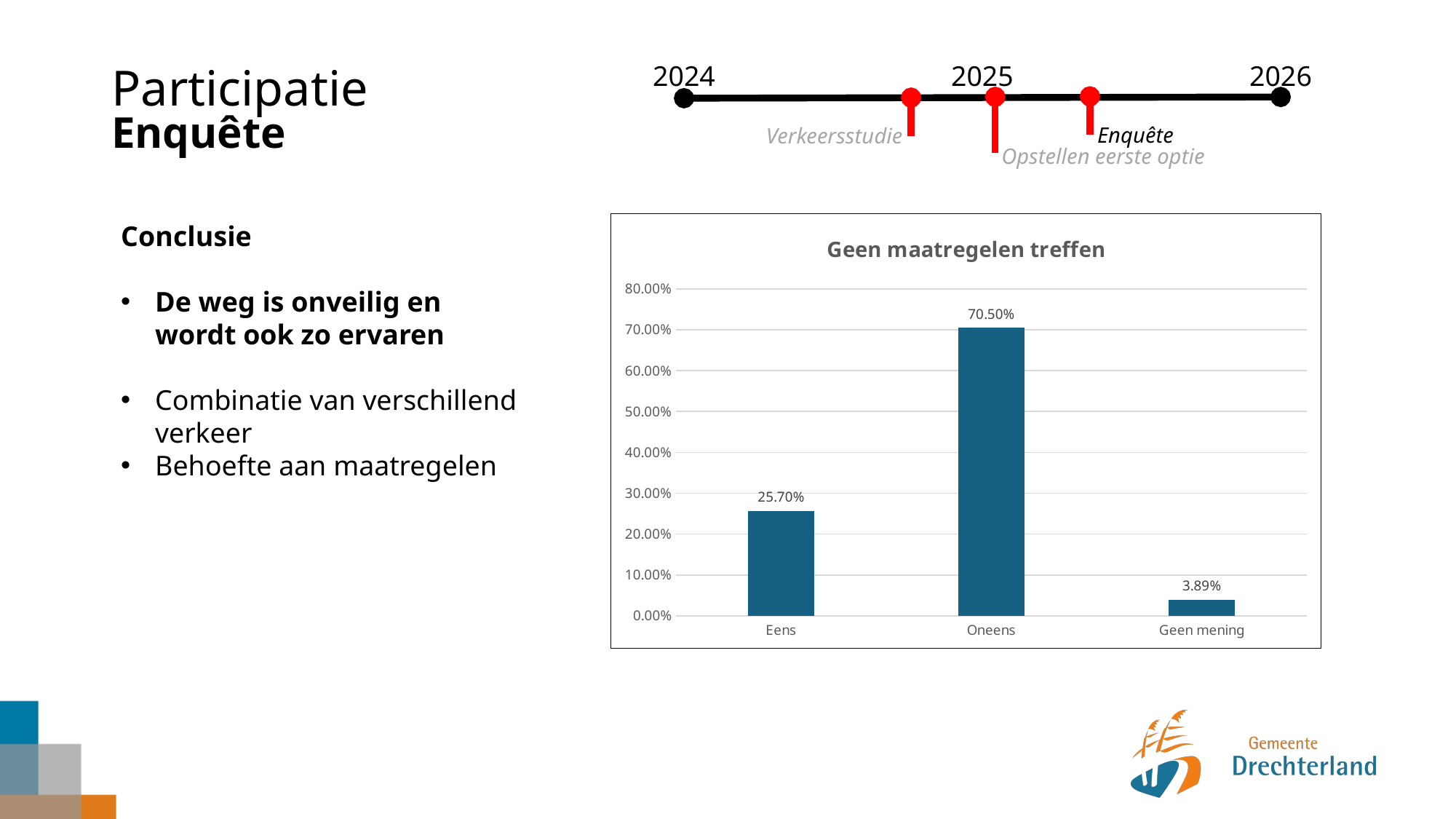
Which is larger, the value for Eens or the value for Geen mening? Eens What is the value for Eens? 25.70% Which category has the highest value? Oneens Is the value for Oneens greater or less than 60.00%? greater What is the highest value shown on the y axis? 80.00% How many categories are shown on the x axis? 3 What is the title of the chart? Geen maatregelen treffen What kind of chart is shown? bar chart Which category has the lowest value? Geen mening What is the value for Oneens? 70.50% What is the value for Geen mening? 3.89% What is the difference between the values for Oneens and Eens? 44.80%